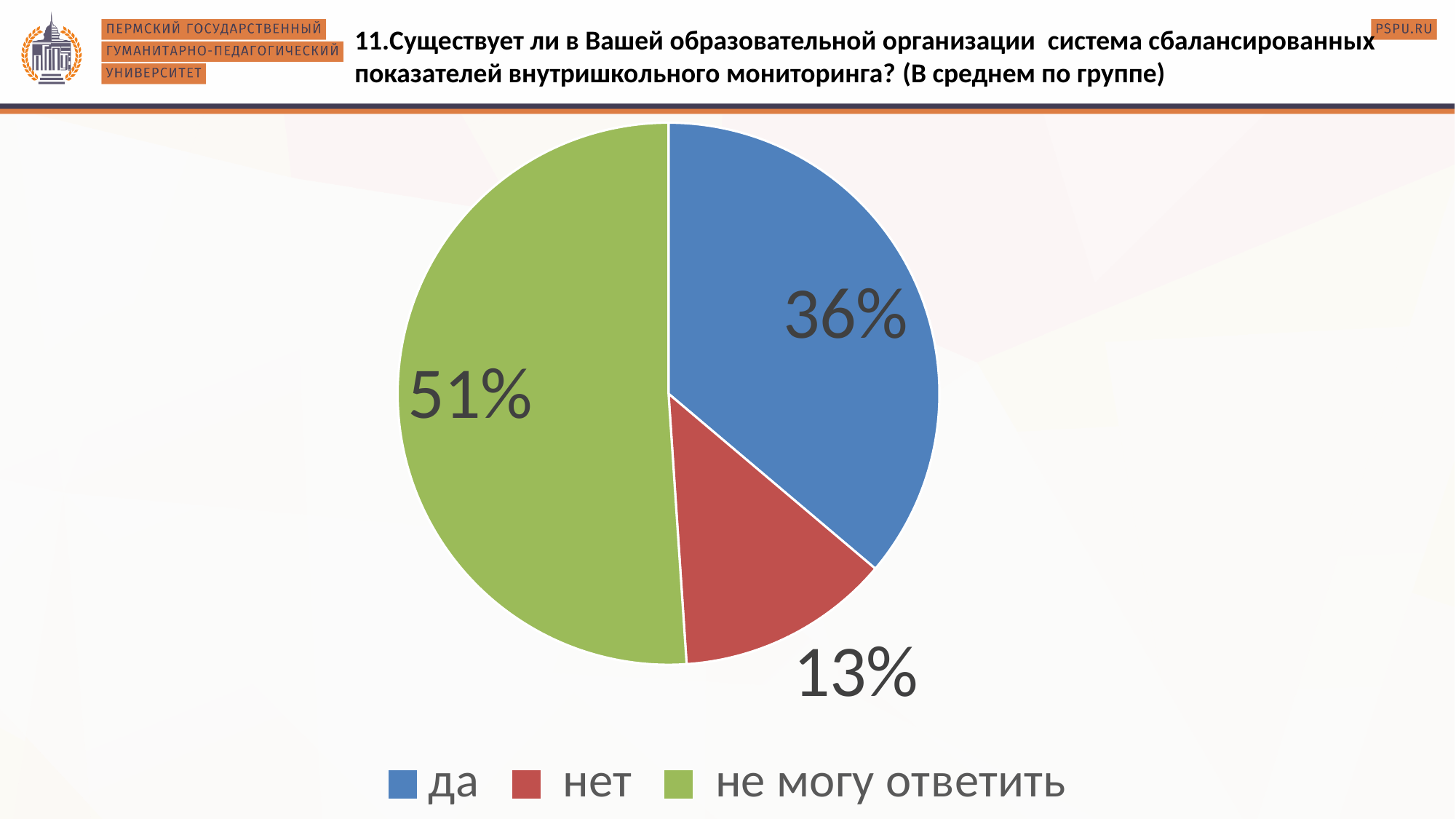
What is the difference in percentage points between the "да" slice and the "нет" slice? 23 What share of the pie is labelled "да"? 36% Which category has the largest slice of the pie? не могу ответить What share of the pie is labelled "не могу ответить"? 51% How many entries does the legend list? 3 What type of chart is shown on the slide? pie chart What is the difference in percentage points between the "не могу ответить" slice and the "да" slice? 15 Which is larger, the "да" slice or the "нет" slice? да How many slices does the pie chart have? 3 Which category has the smallest slice of the pie? нет What colour is the slice for "нет"? red What share of the pie is labelled "нет"? 13%